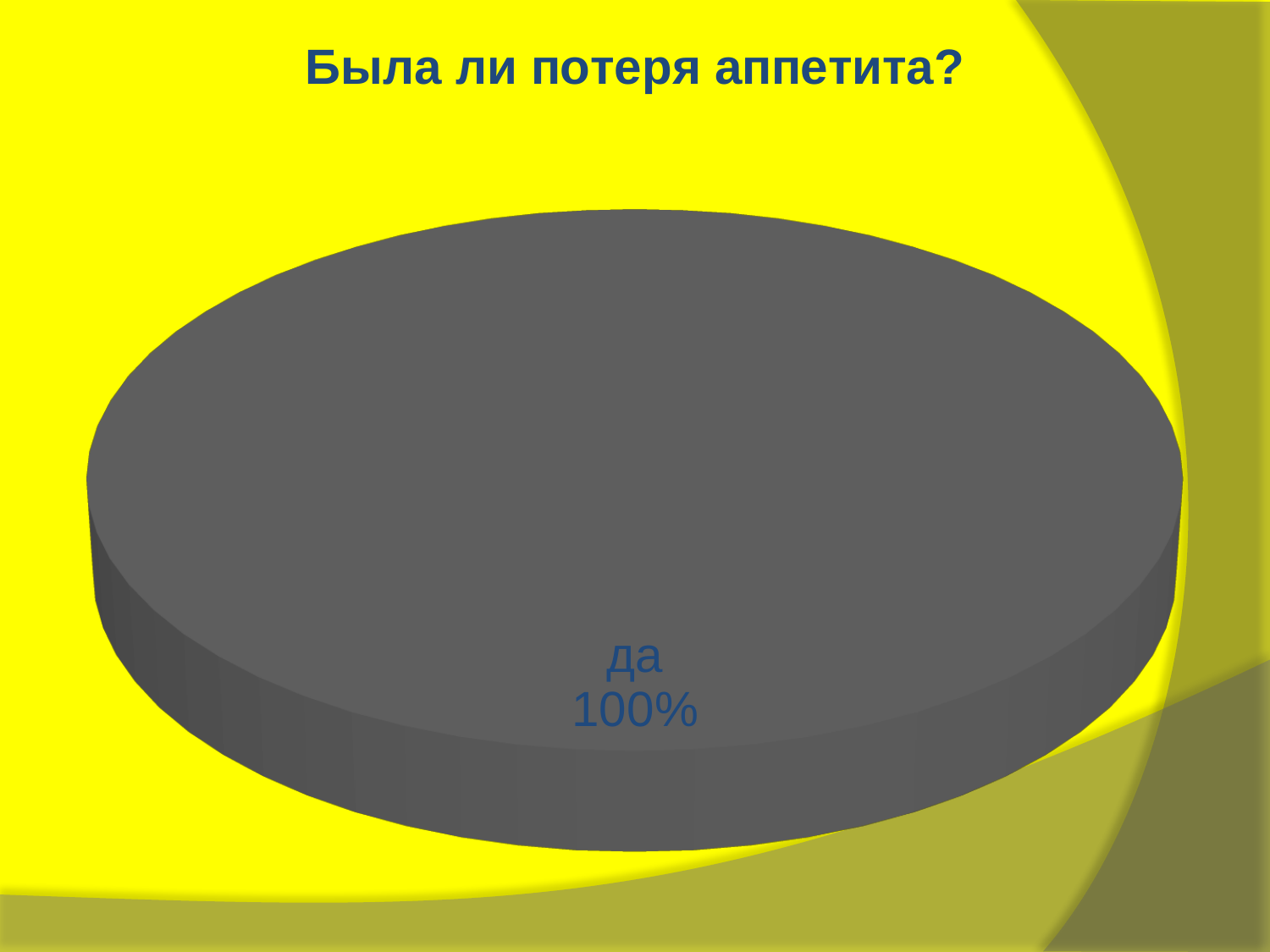
What is the title of the chart? Была ли потеря аппетита? What kind of chart is shown on the slide? pie chart What is the value printed for the category "да"? 100% How many slices does the pie chart have? 1 What share of the pie does the slice "да" take? 100% What is the label of the only slice in the pie chart? да Which category is the largest slice of the pie? да